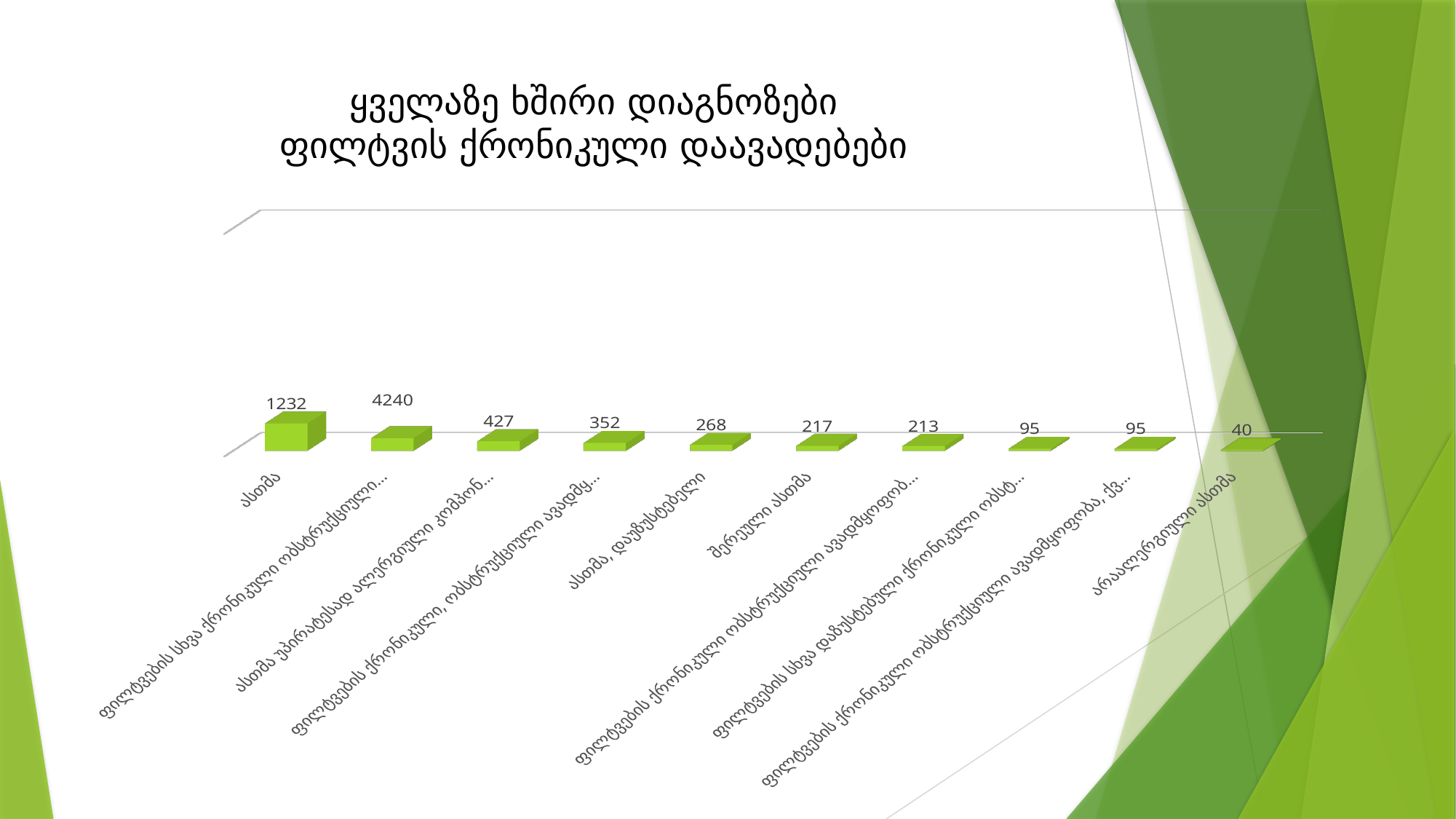
Which is larger, the value for ასთმა or the value for შერეული ასთმა? ასთმა What is the value for არაალერგიული ასთმა? 40 What is the value for ასთმა, დაუზუსტებელი? 268 What is the difference between the values for ასთმა and შერეული ასთმა? 1015 How many bars (categories) does the chart show? 10 What is the difference between the values for ასთმა, დაუზუსტებელი and არაალერგიული ასთმა? 228 What colour are the bars in the chart? green Which category has the lowest value? არაალერგიული ასთმა What is the title of the slide above the chart? ყველაზე ხშირი დიაგნოზები ფილტვის ქრონიკული დაავადებები What is the value for შერეული ასთმა? 217 What kind of chart is shown on the slide? bar chart What is the value for ასთმა? 1232